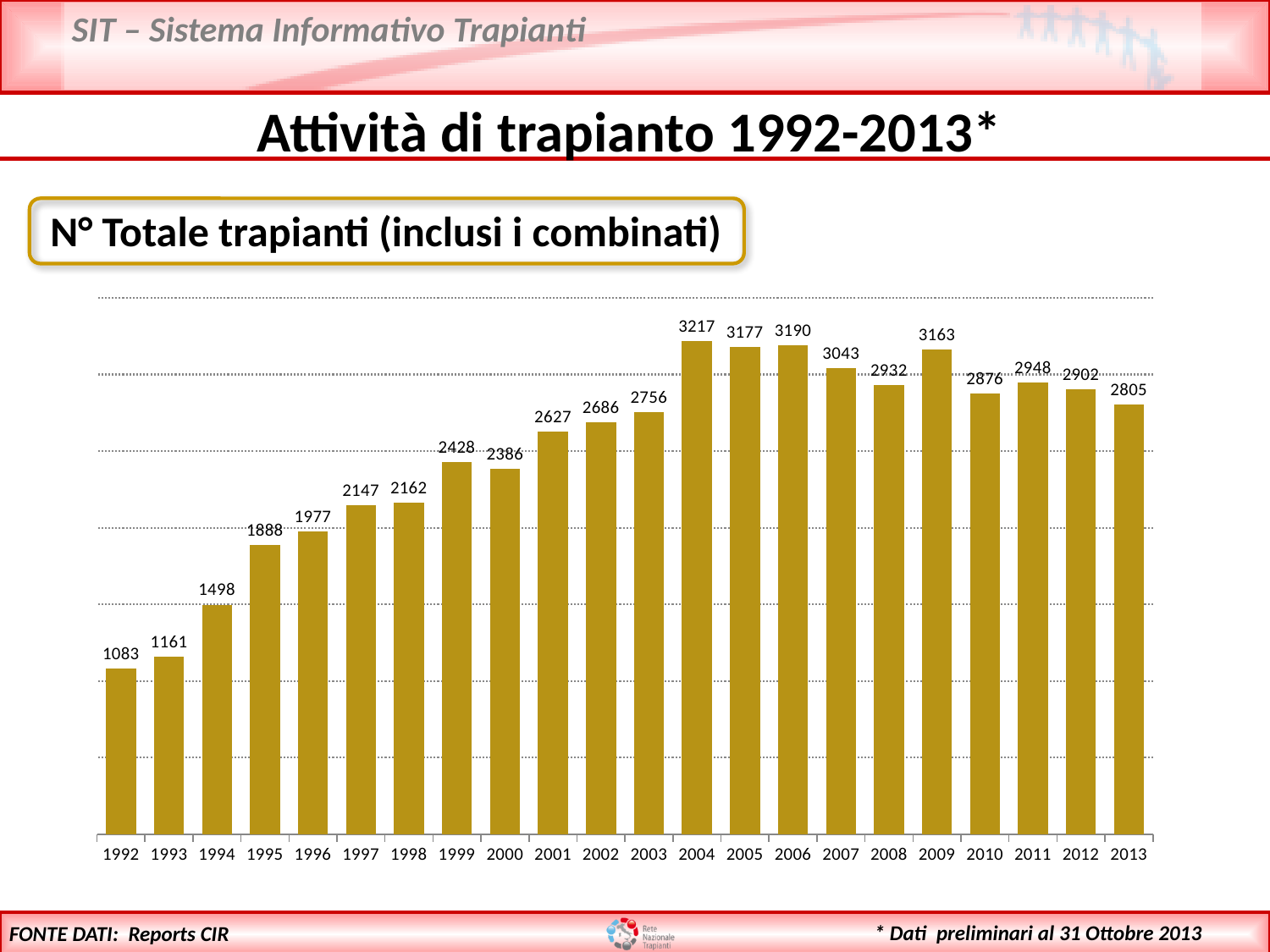
Which is larger, the value for 2009 or the value for 2007? 2009 What value is shown for 1992? 1083 Which year has the highest number of transplants? 2004 What kind of chart is shown on the slide? bar chart What is the total number of transplants shown for 2004? 3217 What value is shown for 2013? 2805 What is the difference between the values for 2012 and 2013? 97 Which year has the lowest number of transplants? 1992 How many years are shown on the x axis? 22 Do the values generally rise or fall from 1992 to 2004? rise Which is larger, the value for 1999 or the value for 2000? 1999 What is the difference between the values for 2004 and 1992? 2134